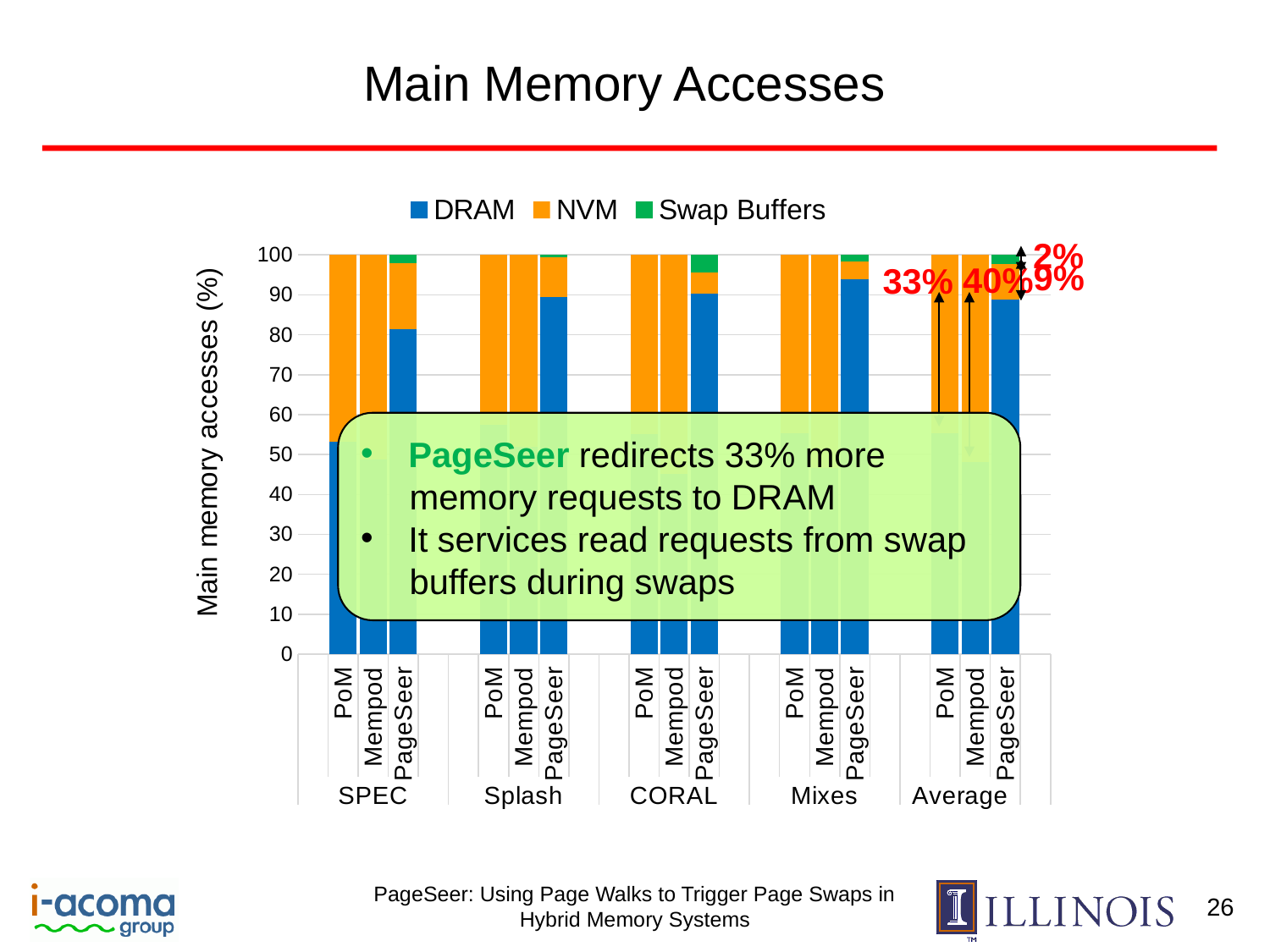
Is the DRAM share for PageSeer in the SPEC group greater or less than 70? greater Is the DRAM share for PageSeer in the Mixes group greater or less than 90? greater What kind of chart is shown on the slide? Stacked bar chart How many benchmark groups are shown along the x axis of the chart? 5 What are the three series named in the chart legend? DRAM, NVM, Swap Buffers What is the label of the chart's y axis? Main memory accesses (%) What percentage is annotated on the chart for PageSeer's improvement over PoM in the Average group? 33% What is the total height of each stacked bar in the chart? 100 Across the benchmark groups, in which group does PageSeer have the lowest DRAM share? SPEC In the SPEC group, which has the larger DRAM share, PoM or PageSeer? PageSeer How many series does the chart legend list? 3 How many bars are plotted in the chart in total? 15